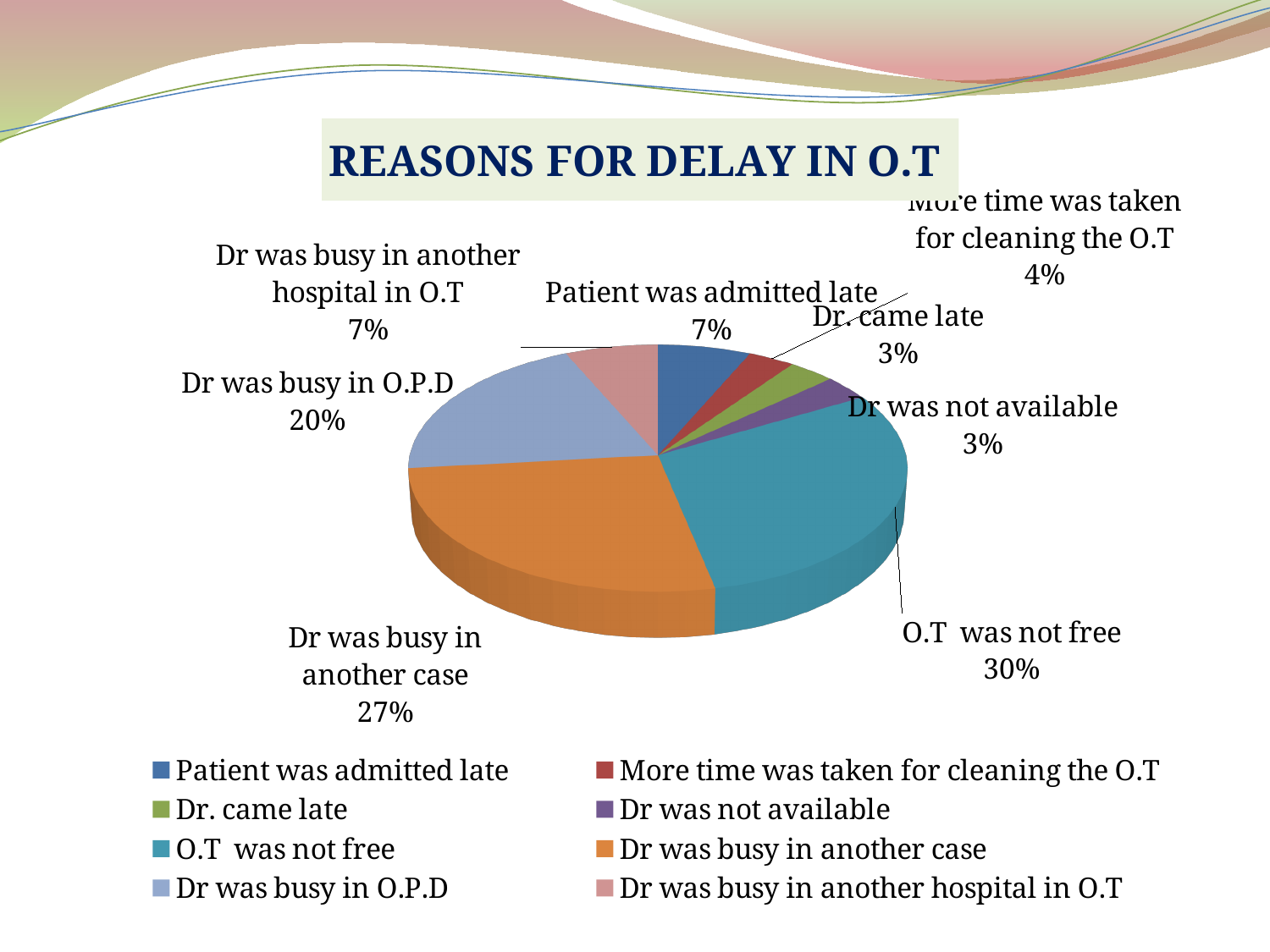
Which reason has the largest share of the pie? O.T was not free What share of the pie is 'O.T was not free'? 30% What share of the pie is 'Dr was busy in O.P.D'? 20% What share of the pie is 'Dr was busy in another case'? 27% What type of chart is shown on the slide? Pie chart What is the combined share of 'Patient was admitted late' and 'Dr was busy in another hospital in O.T'? 14% What is the difference between the shares for 'O.T was not free' and 'Dr was busy in another case'? 3% Which is larger, the share for 'Dr was busy in O.P.D' or the share for 'Patient was admitted late'? Dr was busy in O.P.D How many categories does the legend list? 8 What is the title of the chart? REASONS FOR DELAY IN O.T